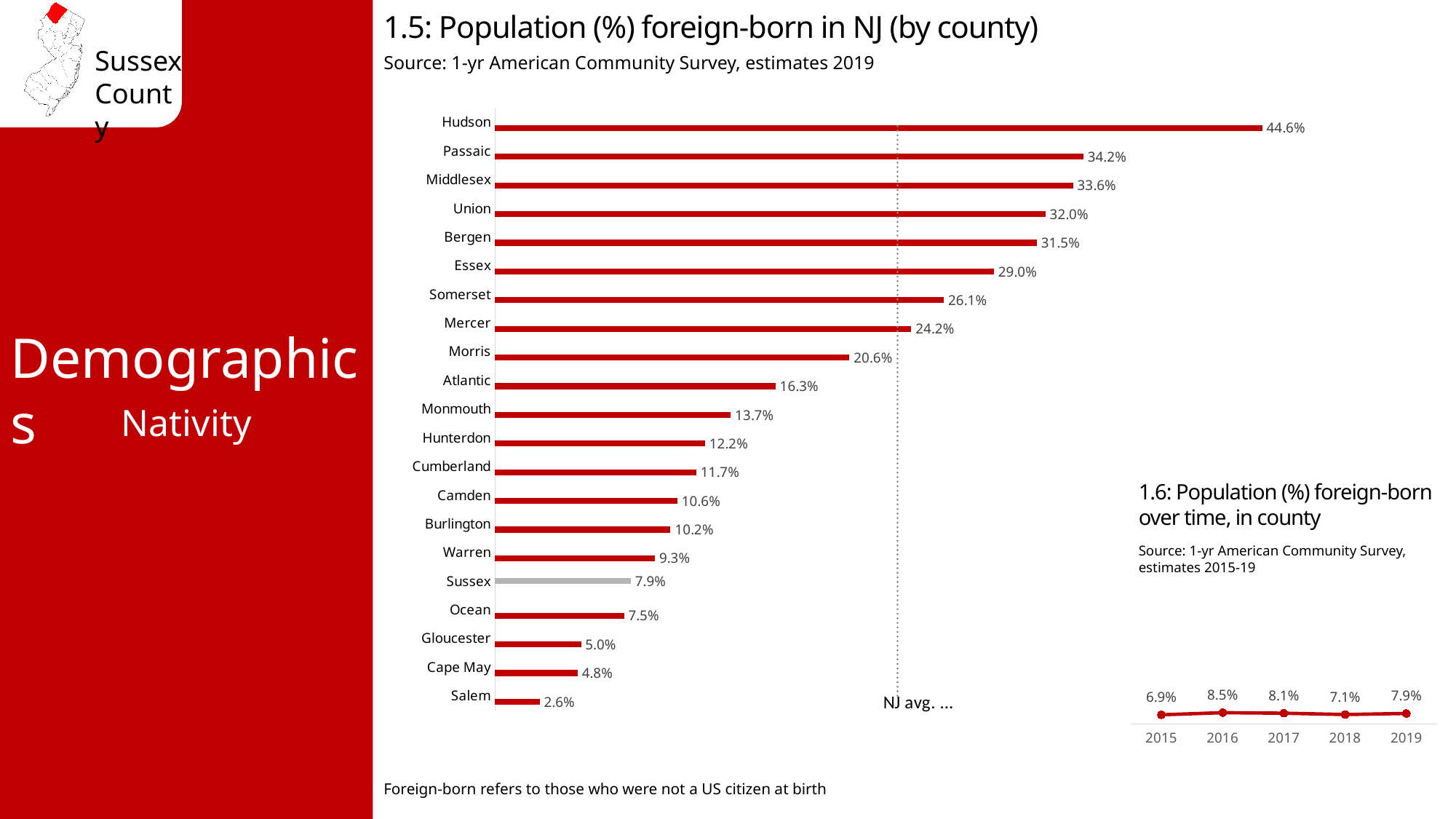
In chart 1.5 (Population (%) foreign-born in NJ by county), how many counties are shown? 21 In chart 1.5 (Population (%) foreign-born in NJ by county), what is the value for Sussex? 7.9% In chart 1.6 (Population (%) foreign-born over time, in county), which year has the lowest value? 2015 In chart 1.5 (Population (%) foreign-born in NJ by county), which is larger, Camden or Burlington? Camden In chart 1.5 (Population (%) foreign-born in NJ by county), which county has the highest value? Hudson What kind of chart is chart 1.5 (Population (%) foreign-born in NJ by county)? Bar chart In chart 1.6 (Population (%) foreign-born over time, in county), how many years are plotted? 5 In chart 1.5 (Population (%) foreign-born in NJ by county), what is the value for Mercer? 24.2% In chart 1.5 (Population (%) foreign-born in NJ by county), what is the difference between Hudson and Passaic? 10.4% In chart 1.6 (Population (%) foreign-born over time, in county), what is the difference between 2016 and 2018? 1.4% In chart 1.5 (Population (%) foreign-born in NJ by county), which county has the lowest value? Salem In chart 1.6 (Population (%) foreign-born over time, in county), what is the value for 2016? 8.5%